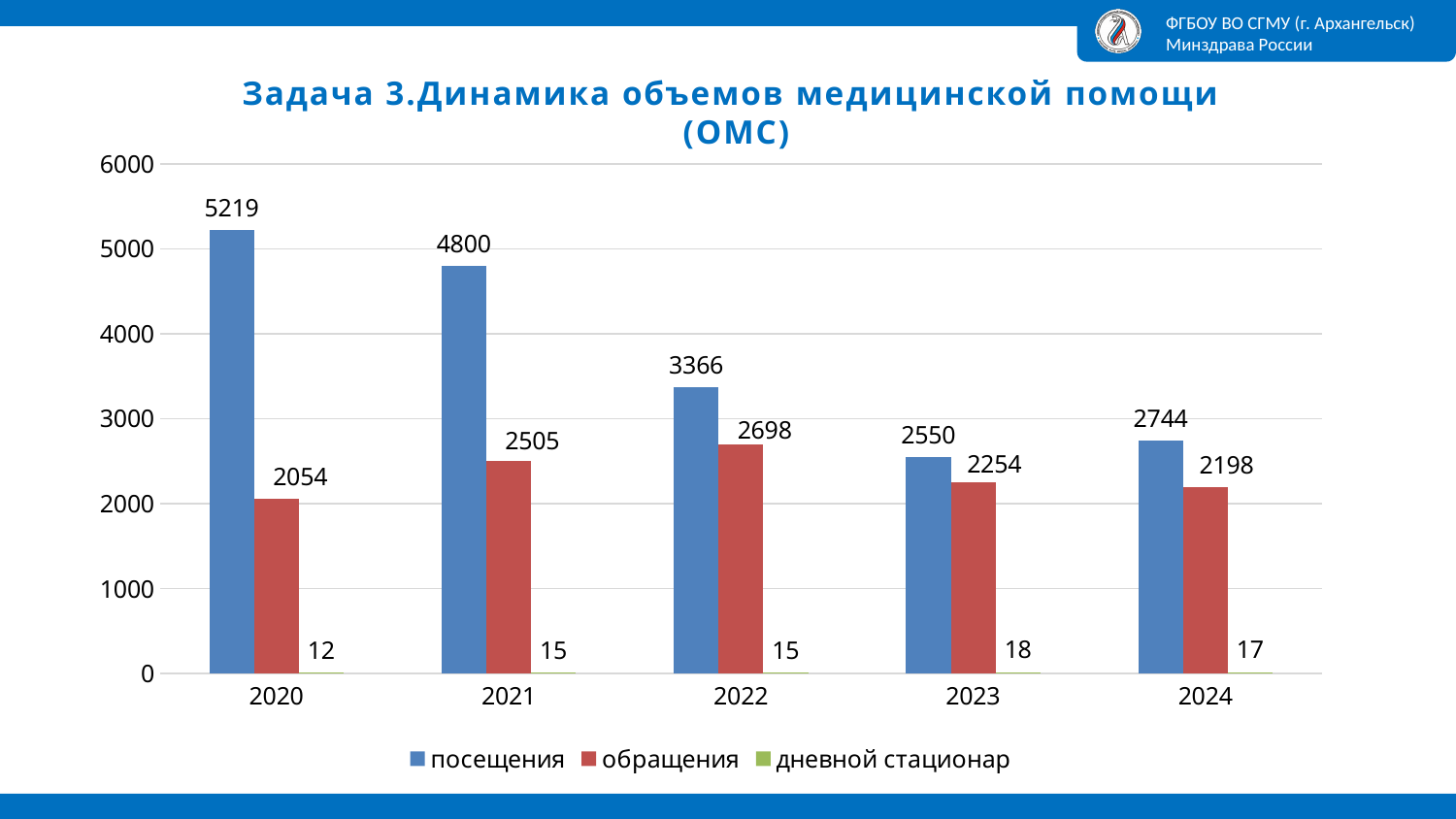
Which is larger: посещения in 2023 or посещения in 2024? посещения in 2024 Does the value for посещения rise or fall from 2020 to 2023? fall In which year is the value for посещения highest? 2020 What is the difference between посещения in 2020 and посещения in 2021? 419 What kind of chart is shown on the slide? bar chart How many series does the legend list? 3 Is the value for посещения in 2022 greater or less than 3000? greater What is the value for дневной стационар in 2023? 18 How many years are shown on the x axis? 5 What is the value for обращения in 2022? 2698 What is the value for посещения in 2020? 5219 In which year is the value for обращения lowest? 2020